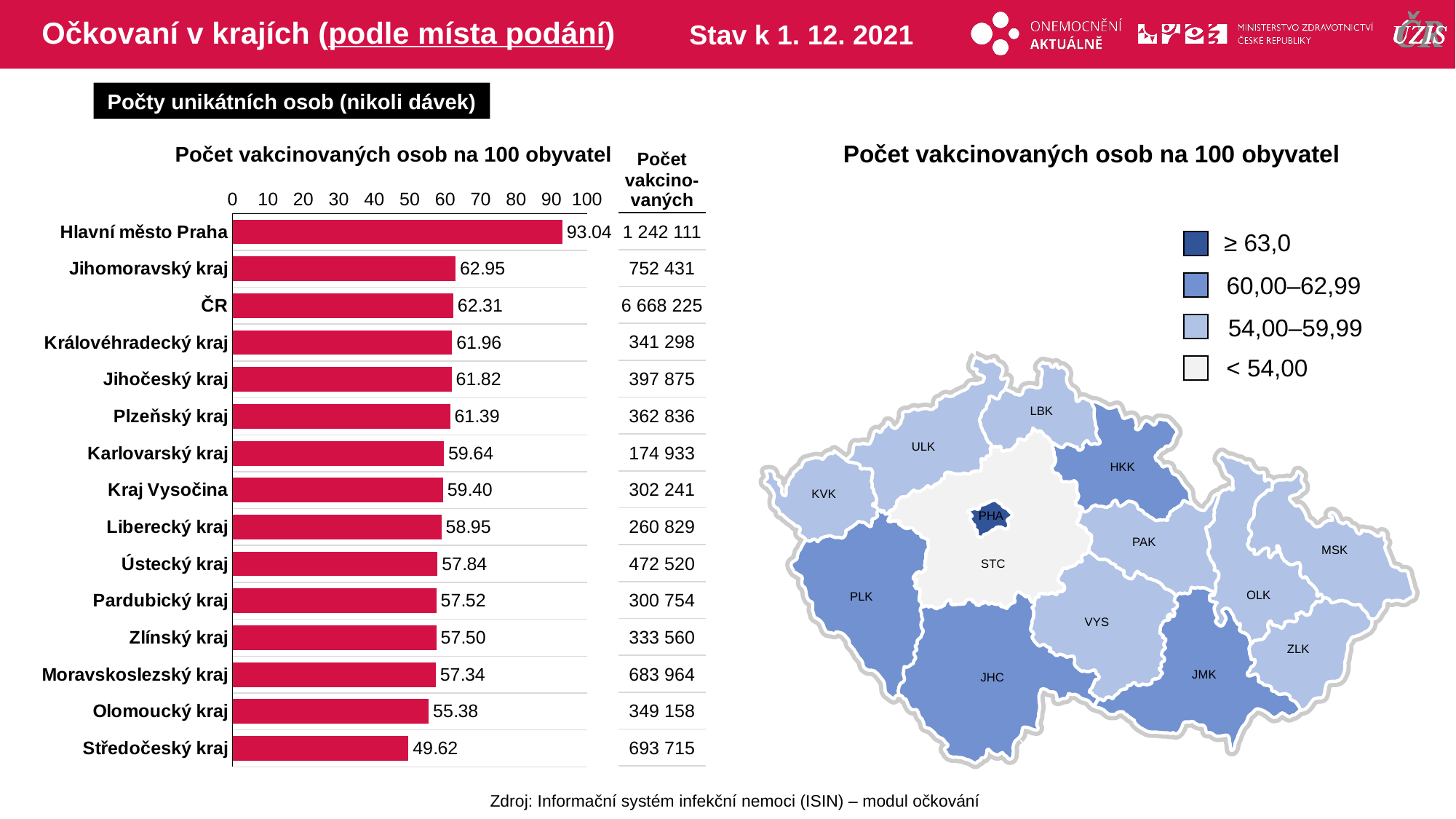
In the bar chart, what is the difference between the values for Hlavní město Praha and Středočeský kraj? 43.42 In the bar chart, which is larger: the value for Olomoucký kraj or the value for Moravskoslezský kraj? Moravskoslezský kraj What kind of chart is used to show the number of vaccinated persons per 100 inhabitants on the left of the slide? bar chart Which region has the lowest number of vaccinated persons per 100 inhabitants in the bar chart? Středočeský kraj In the bar chart, what is the value for Hlavní město Praha? 93.04 In the bar chart, what is the value for ČR? 62.31 Which region has the highest number of vaccinated persons per 100 inhabitants in the bar chart? Hlavní město Praha Do the values in the bar chart rise or fall going from the top bar to the bottom bar? fall In the bar chart, what is the value for Středočeský kraj? 49.62 In the bar chart, is the value for Karlovarský kraj greater or less than 60? less How many bars (categories) are shown in the bar chart? 15 According to the column next to the bar chart, what is the 'Počet vakcinovaných' for Jihomoravský kraj? 752 431